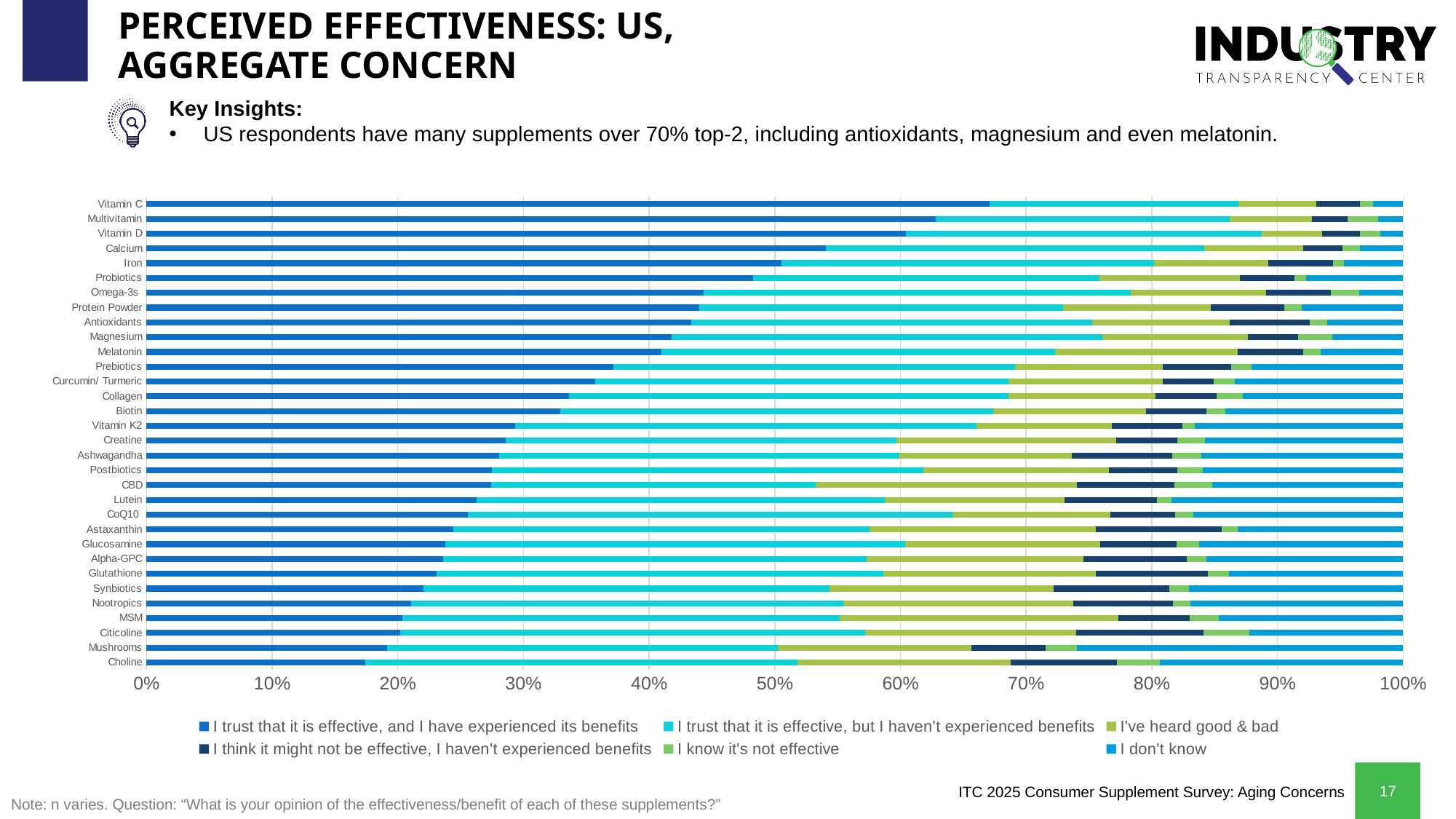
What is the maximum value shown on the horizontal axis? 100% Which supplement is listed at the top of the chart? Vitamin C Is the "I trust that it is effective, and I have experienced its benefits" share for Calcium greater or less than 50%? greater Which supplement has the largest share for "I trust that it is effective, and I have experienced its benefits"? Vitamin C How many series does the legend list? 6 Is the "I trust that it is effective, and I have experienced its benefits" share for Choline greater or less than 20%? less Which has a larger "I trust that it is effective, and I have experienced its benefits" share, Multivitamin or Mushrooms? Multivitamin Moving from the top of the chart to the bottom, does the "I trust that it is effective, and I have experienced its benefits" share rise or fall? fall How many supplements (categories) are listed on the chart? 32 What kind of chart is shown on the slide? Stacked bar chart Which supplement has the smallest share for "I trust that it is effective, and I have experienced its benefits"? Choline Is the "I trust that it is effective, and I have experienced its benefits" share for Vitamin C greater or less than 60%? greater